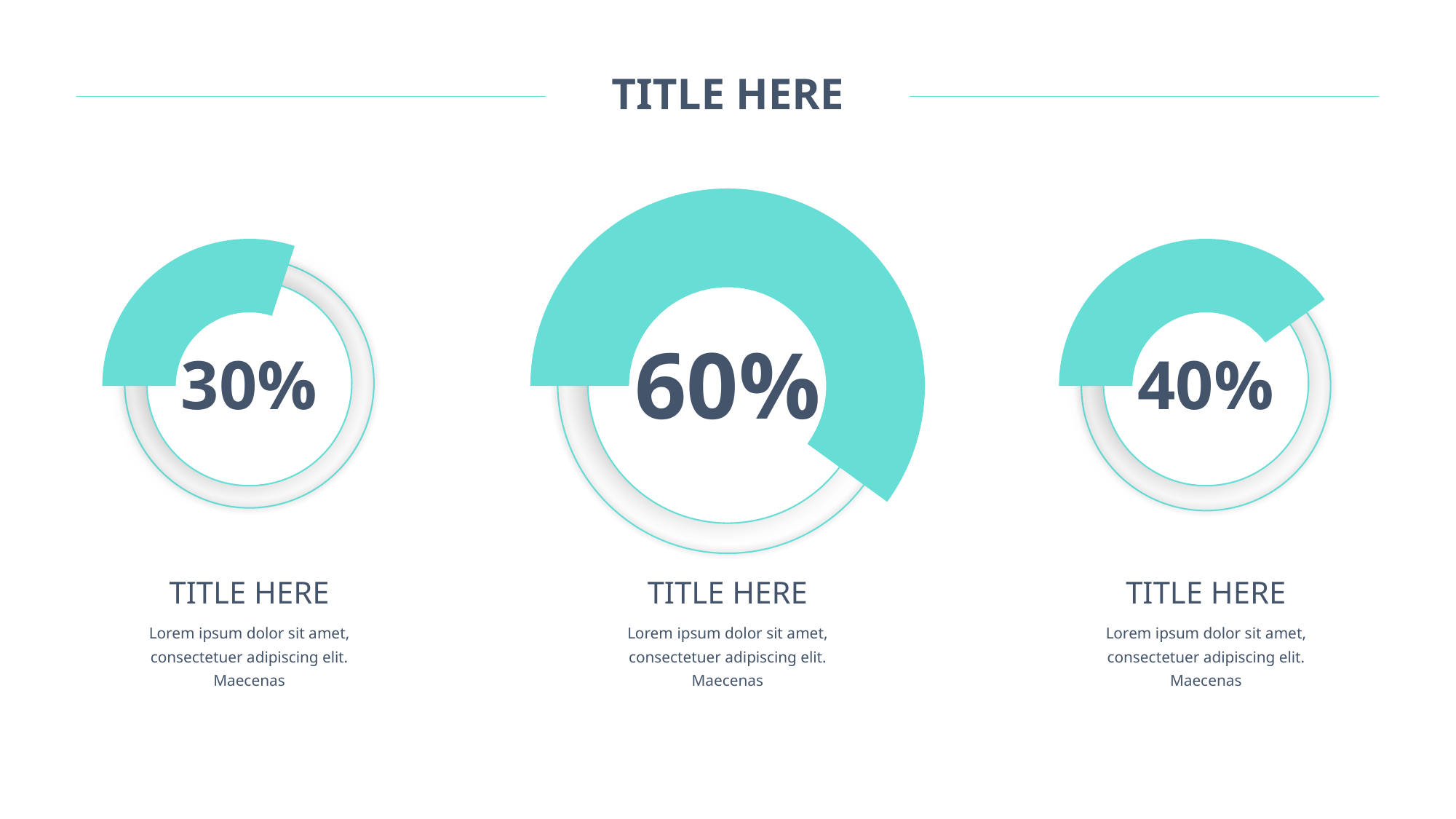
How many percentage charts are shown on the slide? 3 What percentage is shown in the left chart? 30% What is the difference between the percentage in the middle chart and the percentage in the right chart? 20% Is the percentage in the right chart larger or smaller than the percentage in the left chart? larger Which of the three charts shows the lowest percentage: left, middle or right? left What percentage is shown in the right chart? 40% What is the difference between the percentage in the middle chart and the percentage in the left chart? 30% What percentage is shown in the middle chart? 60% What kind of chart is used to display the percentages on the slide? doughnut chart Which of the three charts shows the highest percentage: left, middle or right? middle Is the percentage in the middle chart greater or less than 50%? greater What colour is the filled portion of each doughnut chart? teal